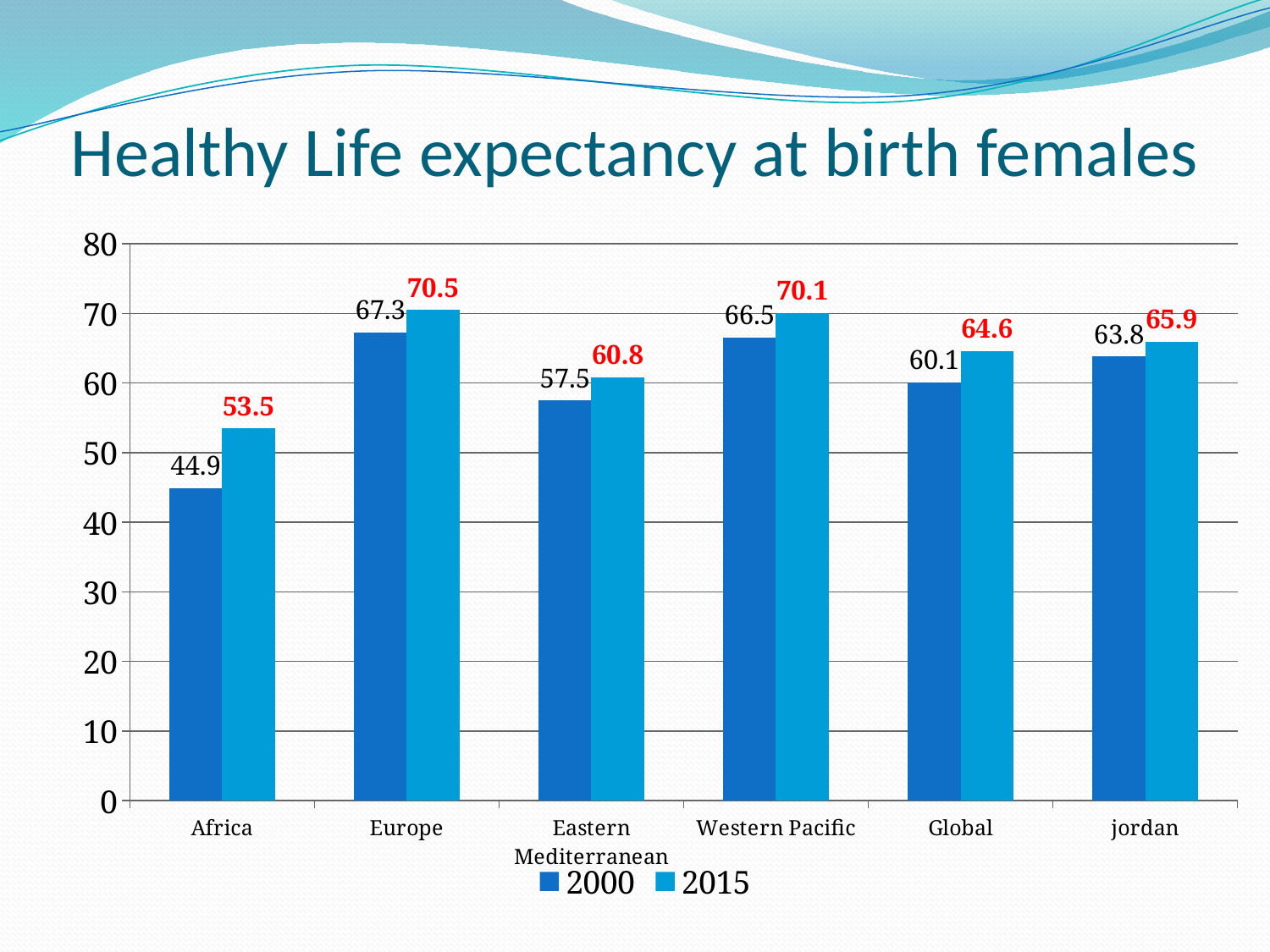
Which is larger, the 2000 value for Western Pacific or the 2000 value for jordan? Western Pacific What is the difference between the 2015 and 2000 values for Global? 4.5 What is the 2015 value for jordan? 65.9 What is the 2015 value for Africa? 53.5 Which category has the highest 2015 value? Europe What kind of chart is shown on the slide? Bar chart What is the 2000 value for Eastern Mediterranean? 57.5 How many series does the legend list? 2 What is the difference between the 2015 and 2000 values for Africa? 8.6 What is the 2000 value for Europe? 67.3 Which category has the lowest 2000 value? Africa How many categories are shown on the x axis? 6